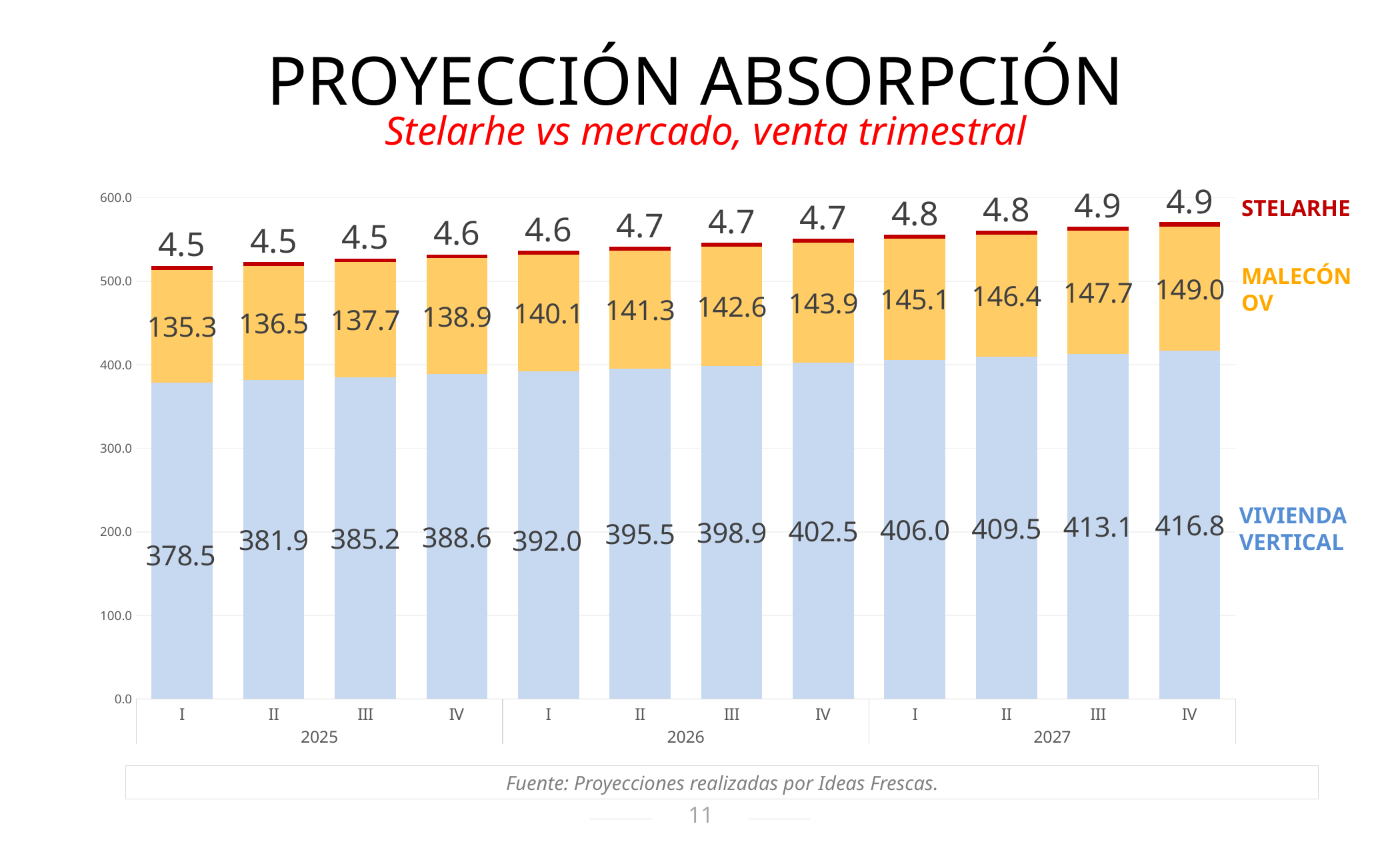
What is the MALECÓN OV value for quarter IV of 2027? 149.0 In which quarter is the VIVIENDA VERTICAL value highest? IV 2027 Which series is shown in red at the top of each bar? STELARHE What is the STELARHE value for quarter II of 2026? 4.7 In which quarter is the MALECÓN OV value lowest? I 2025 How many quarterly bars are plotted in the chart? 12 Do the VIVIENDA VERTICAL values rise or fall from 2025 to 2027? Rise What is the VIVIENDA VERTICAL value for quarter I of 2025? 378.5 How many series does the chart show? 3 What is the total of the stacked bar for quarter I of 2025? 518.3 What is the difference between the VIVIENDA VERTICAL value in quarter IV of 2027 and quarter I of 2025? 38.3 What type of chart is shown on the slide? Stacked bar chart